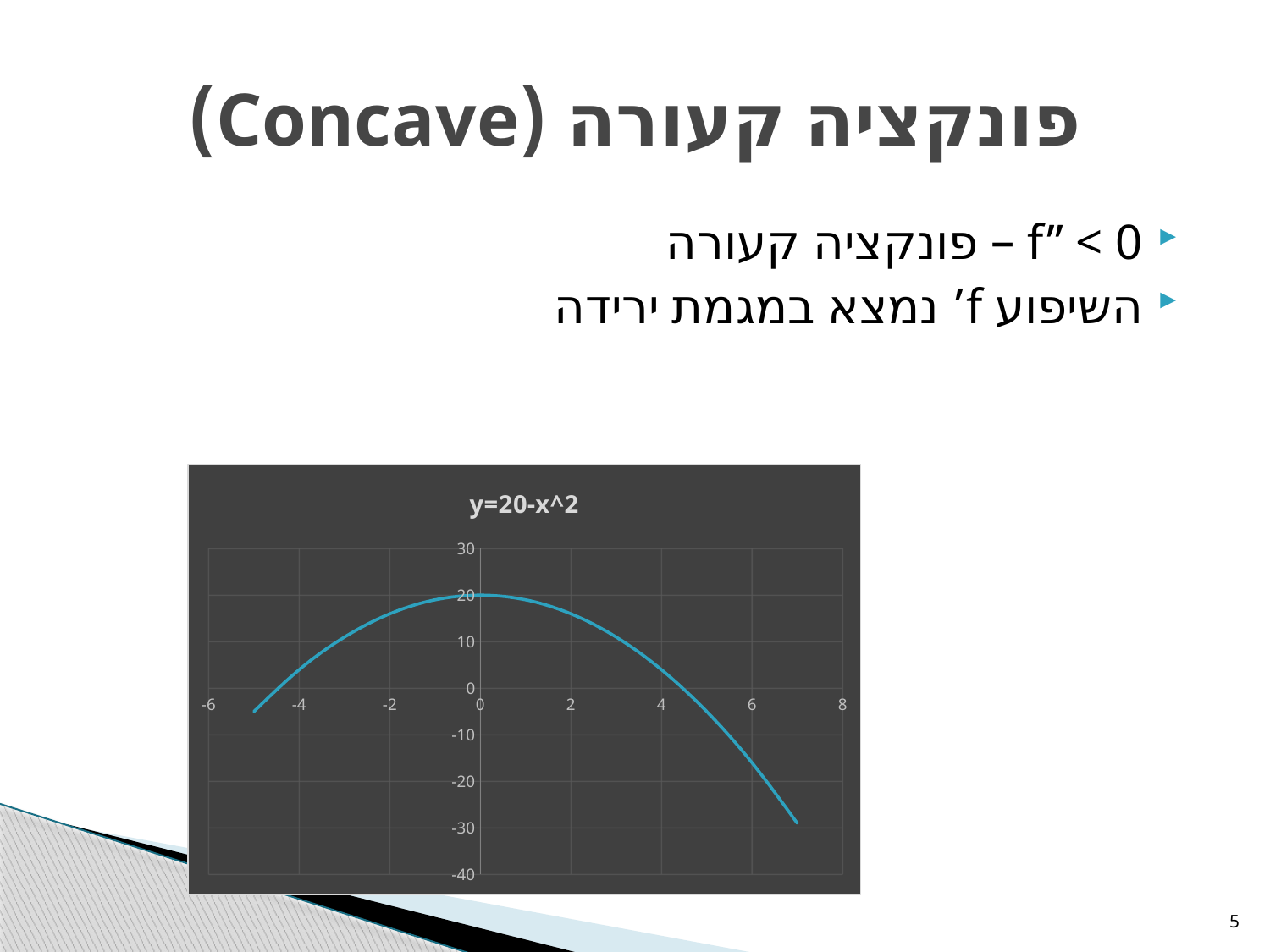
Is the value of the curve at x = 4 greater or less than 0? greater What is the title of the chart? y=20-x^2 What is the highest y value the curve reaches? 20 Is the value of the curve at x = 4 greater or less than 10? less Which is larger, the value of the curve at x = 2 or at x = 6? x = 2 Does the curve rise or fall as x increases from 0 to 8? fall Is the value of the curve at x = 2 greater or less than 10? greater Does the curve rise or fall as x increases from -6 to 0? rise What is the lowest value shown on the y axis? -40 What kind of chart is shown on the slide? line chart At which x value does the curve reach its highest point? 0